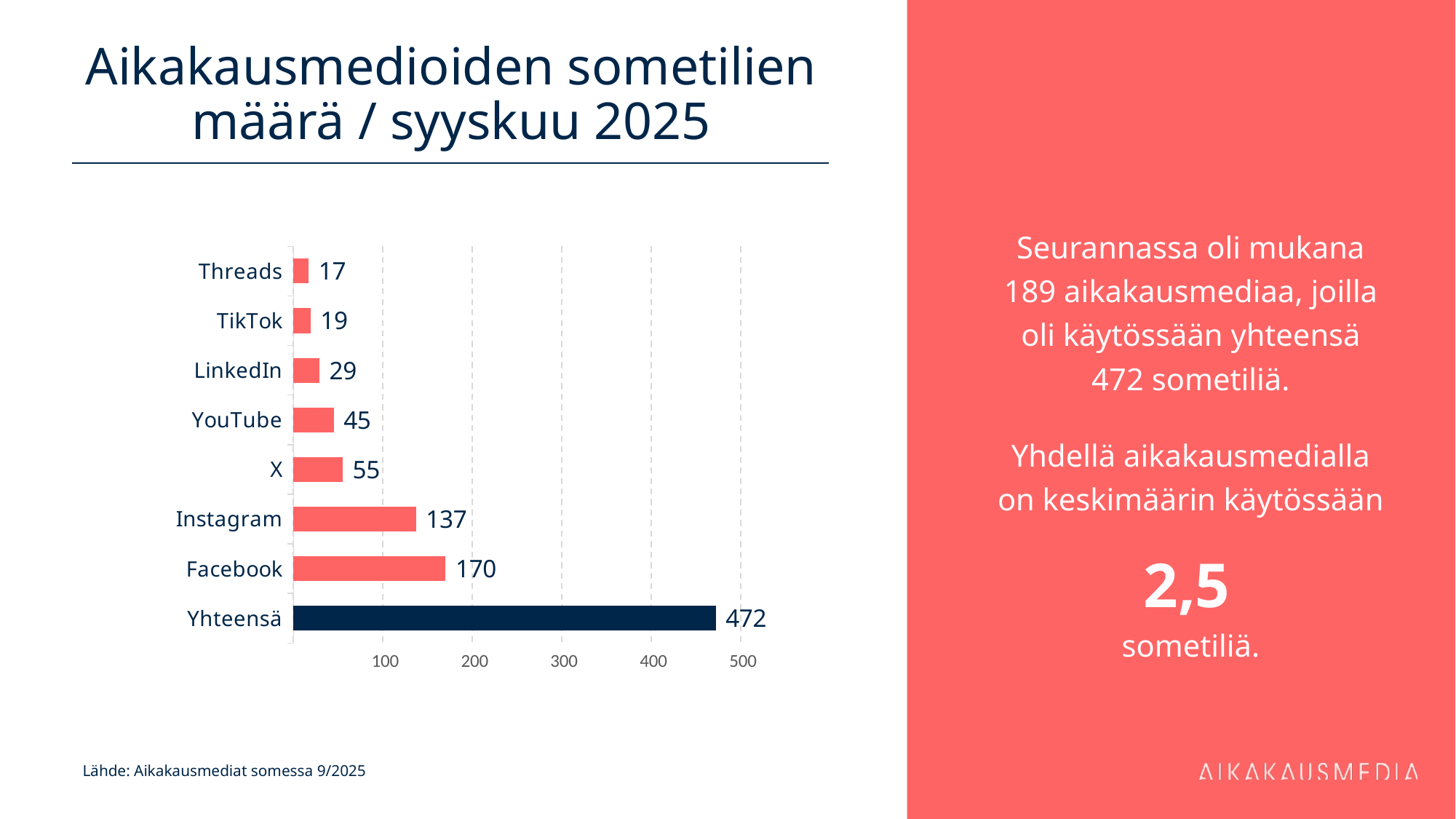
Excluding the Yhteensä total bar, which platform has the highest value? Facebook Which platform has the lowest value? Threads What is the title of the slide? Aikakausmedioiden sometilien määrä / syyskuu 2025 What is the value for Facebook? 170 What is the value shown for Yhteensä? 472 Is the value for Instagram greater or less than 100? greater What is the difference between the values for Facebook and Instagram? 33 What is the value for Instagram? 137 What is the value for LinkedIn? 29 Which has a larger value, X or YouTube? X What kind of chart is shown on the slide? Bar chart How many bars are shown in the chart, including the Yhteensä total bar? 8